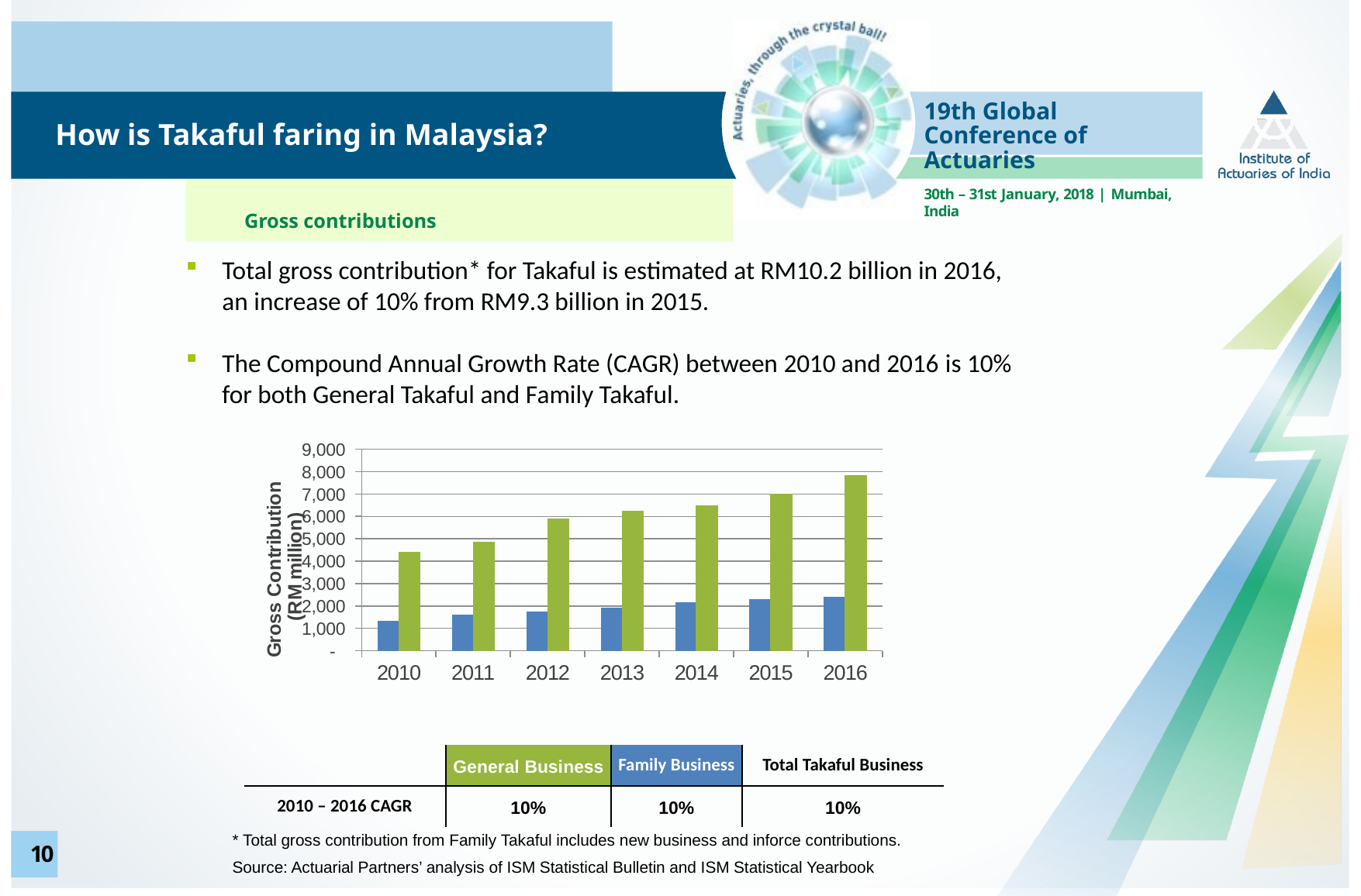
Is the value of the green (General Business) bar for 2016 greater or less than 7,000? greater In 2013, which bar is taller, the green (General Business) bar or the blue (Family Business) bar? green (General Business) In which year is the green (General Business) bar the tallest? 2016 How many bars are plotted for each year in the chart? 2 What kind of chart is shown on the slide? bar chart In which year is the blue (Family Business) bar the shortest? 2010 How many years are shown on the x axis of the chart? 7 What is the label of the vertical axis of the chart? Gross Contribution (RM million) According to the table key below the chart, which business does the green bar represent? General Business Is the value of the blue (Family Business) bar for 2010 greater or less than 2,000? less Is the value of the green (General Business) bar for 2010 greater or less than 4,000? greater Do the green (General Business) bars rise or fall from 2010 to 2016? rise